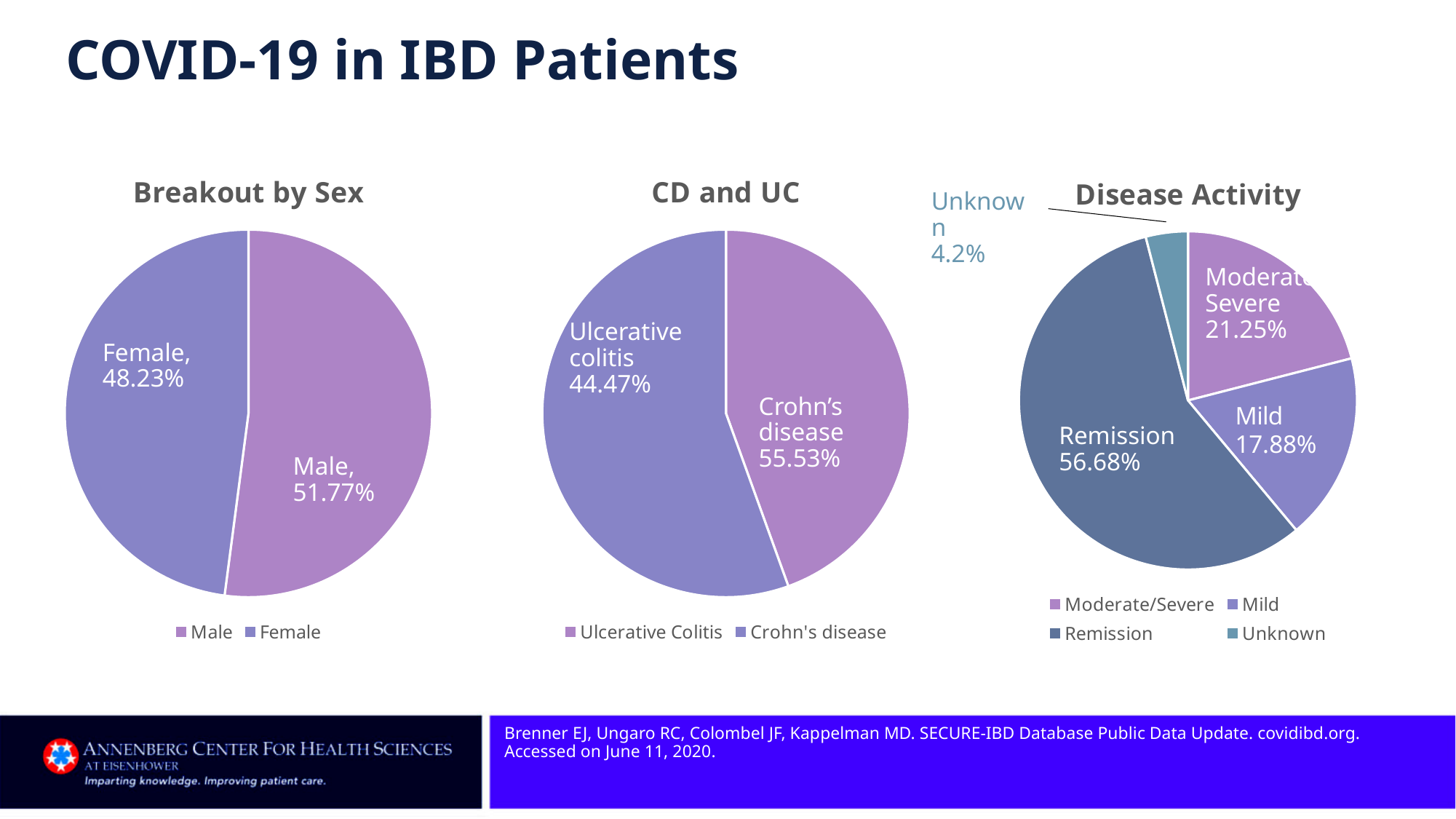
In the 'CD and UC' chart, how many percentage points larger is the Crohn's disease share than the Ulcerative colitis share? 11.06 percentage points In the 'Breakout by Sex' chart, what share of patients is Female? 48.23% In the 'CD and UC' chart, what share of patients have Crohn's disease? 55.53% What type of chart is used for 'Disease Activity'? Pie chart In the 'Disease Activity' chart, which category has the smallest share? Unknown In the 'CD and UC' chart, what share of patients have Ulcerative colitis? 44.47% In the 'Disease Activity' chart, which category has the largest share? Remission In the 'Disease Activity' chart, what share of patients are in Remission? 56.68% In the 'Breakout by Sex' chart, what is the difference in percentage points between the Male and Female shares? 3.54 percentage points In the 'Disease Activity' chart, how many categories does the legend list? 4 In the 'Breakout by Sex' chart, what share of patients is Male? 51.77% In the 'Breakout by Sex' chart, which slice is larger, Male or Female? Male